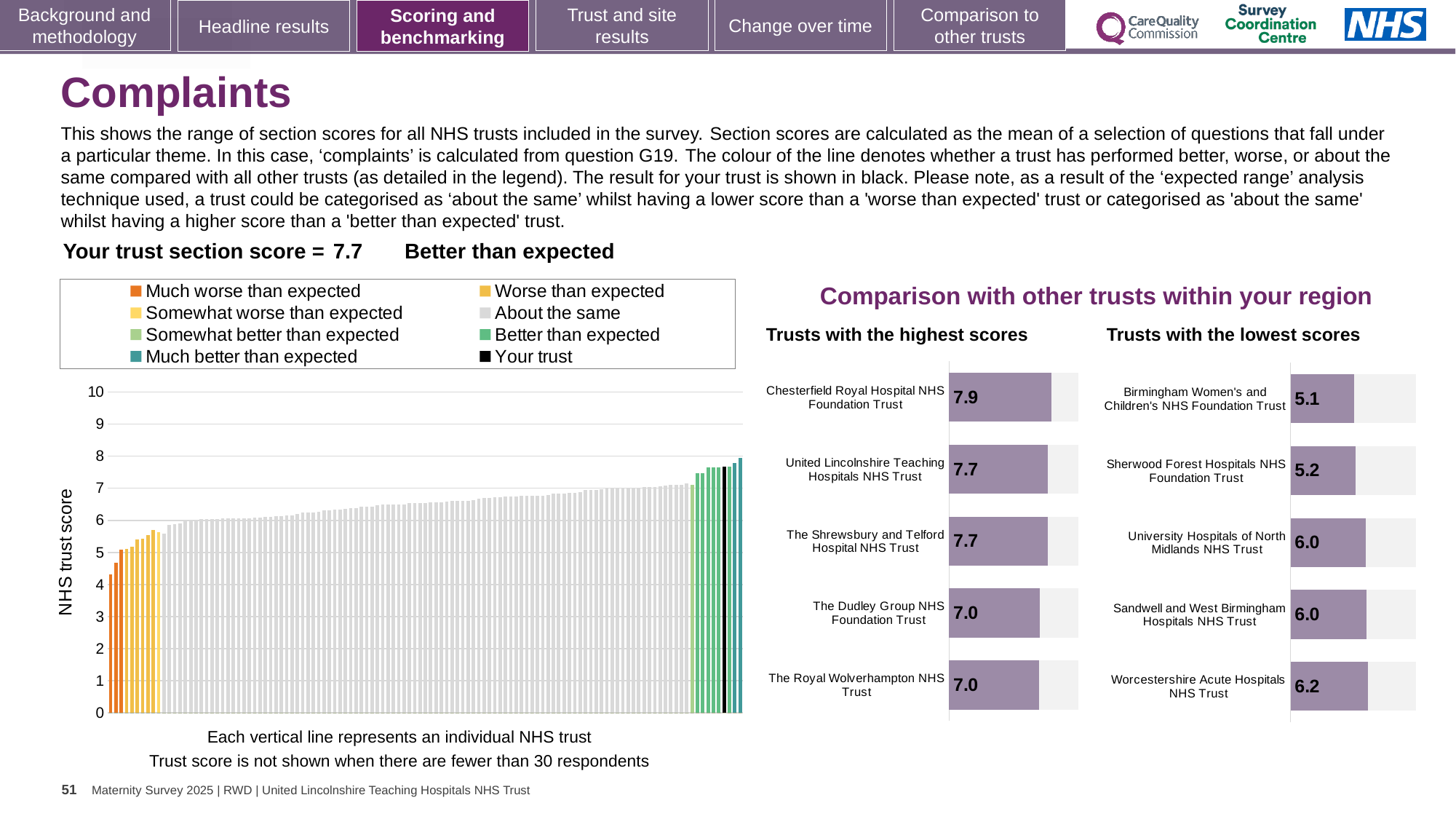
What kind of chart is the large chart on the left with the y axis labelled 'NHS trust score'? Bar chart In the large chart on the left, do the bars rise or fall from left to right? Rise In the 'Trusts with the lowest scores' chart, which trust has the lowest score? Birmingham Women's and Children's NHS Foundation Trust In the 'Trusts with the lowest scores' chart, which has the larger score: Sherwood Forest Hospitals NHS Foundation Trust or Worcestershire Acute Hospitals NHS Trust? Worcestershire Acute Hospitals NHS Trust In the large chart on the left, is the value of the leftmost (lowest) bar greater or less than 5? less What is the section score for your trust shown on the slide? 7.7 How many entries does the legend above the large chart on the left list? 8 In the 'Trusts with the highest scores' chart, what is the difference between the scores of Chesterfield Royal Hospital NHS Foundation Trust and The Dudley Group NHS Foundation Trust? 0.9 In the 'Trusts with the highest scores' chart, how many trusts are shown? 5 In the 'Trusts with the lowest scores' chart, what is the score for Worcestershire Acute Hospitals NHS Trust? 6.2 In the 'Trusts with the highest scores' chart, what is the score for Chesterfield Royal Hospital NHS Foundation Trust? 7.9 In the 'Trusts with the lowest scores' chart, what is the difference between the scores of Worcestershire Acute Hospitals NHS Trust and Birmingham Women's and Children's NHS Foundation Trust? 1.1